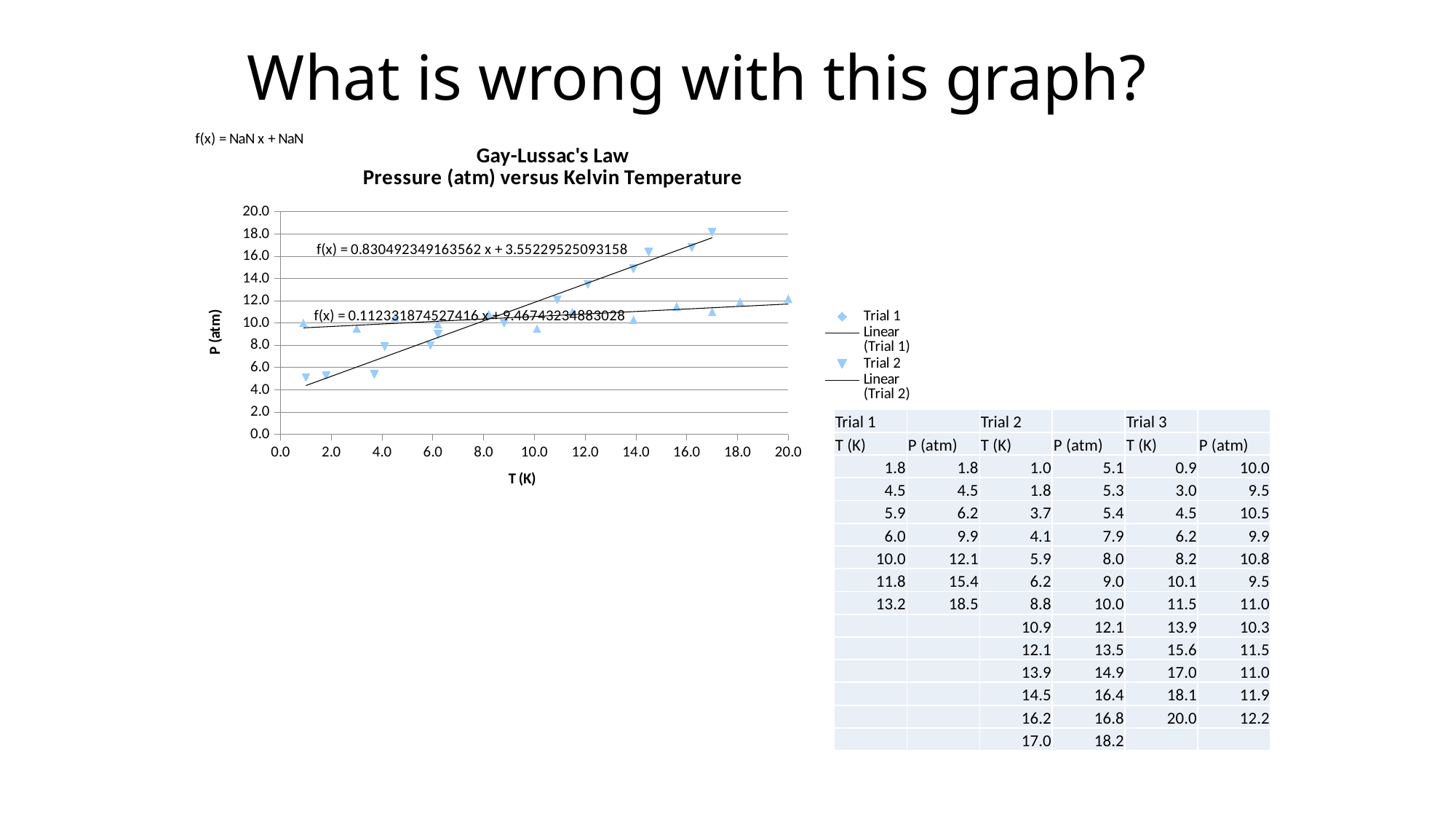
How many entries does the chart legend list? 4 What is the intercept shown in the trendline equation f(x) = 0.112331874527416 x + ? 9.46743234883028 What kind of chart is shown on the slide? scatter chart Is the Trial 1 value at T = 20.0 greater or less than 14.0 atm? less At about T = 17.0, which series has the higher pressure, Trial 1 or Trial 2? Trial 2 What is the label of the chart's vertical axis? P (atm) At about T = 1.0, which series has the higher pressure, Trial 1 or Trial 2? Trial 1 What is the title of the chart? Gay-Lussac's Law Pressure (atm) versus Kelvin Temperature Do the Trial 2 values rise or fall as T (K) increases? rise Is the Trial 2 value at about T = 16.2 greater or less than 16.0 atm? greater What is the slope shown in the trendline equation for the steeper line, f(x) = ? x + 3.55229525093158? 0.830492349163562 Is the Trial 2 value at the lowest temperature (about T = 1.0) greater or less than 6.0 atm? less